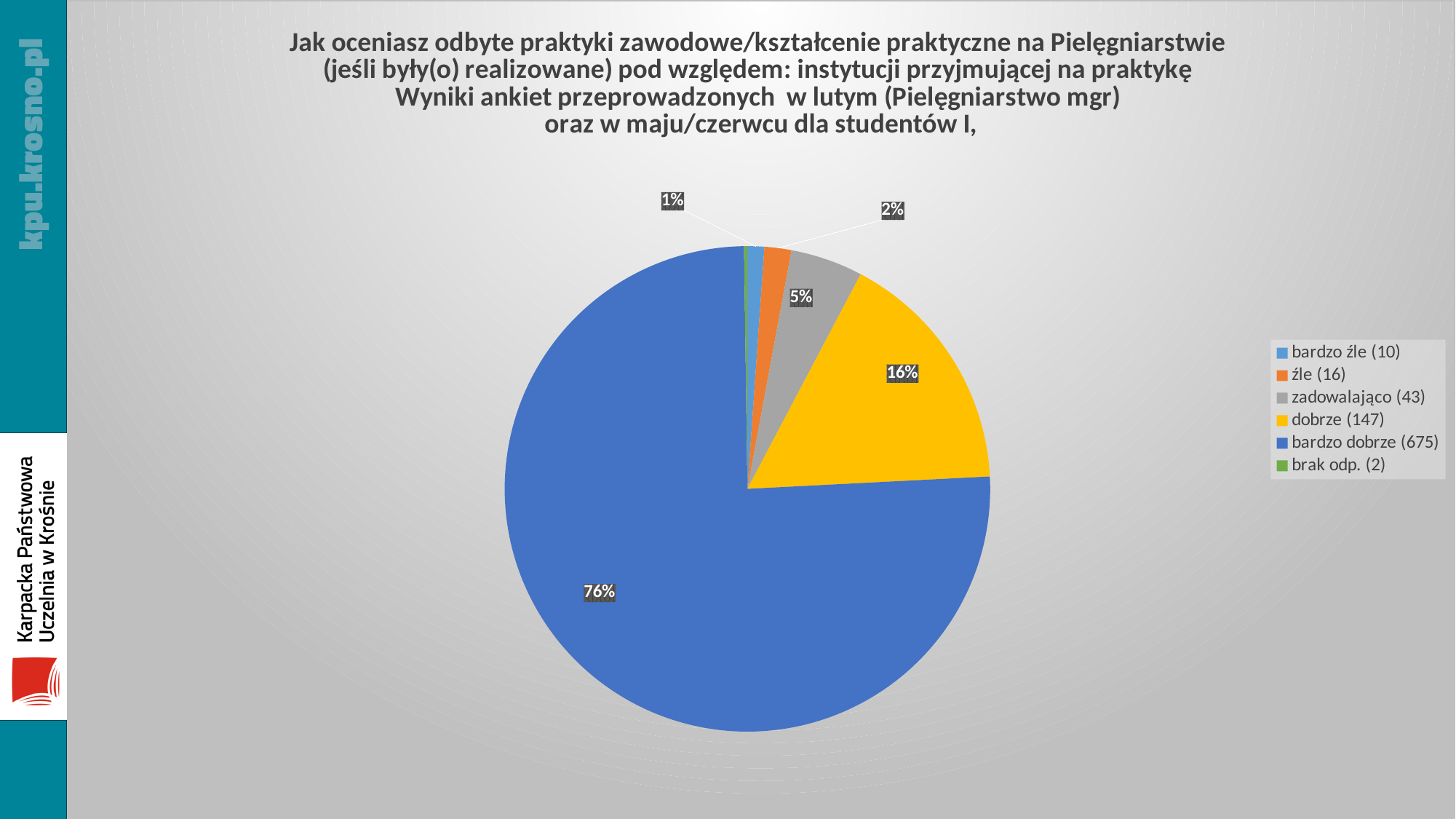
What share of the pie does the 'dobrze' slice represent? 16% What is the difference in percentage points between the 'bardzo dobrze' slice and the 'dobrze' slice? 60% What share of the pie does the 'bardzo źle' slice represent? 1% What share of the pie does the 'źle' slice represent? 2% What kind of chart is shown on the slide? pie chart According to the legend, how many responses are in the 'bardzo dobrze' category? 675 What colour is the 'dobrze' slice in the pie chart? yellow How many categories does the legend of the pie chart list? 6 Which is larger, the 'dobrze' slice or the 'zadowalająco' slice? dobrze Which category has the largest slice of the pie? bardzo dobrze